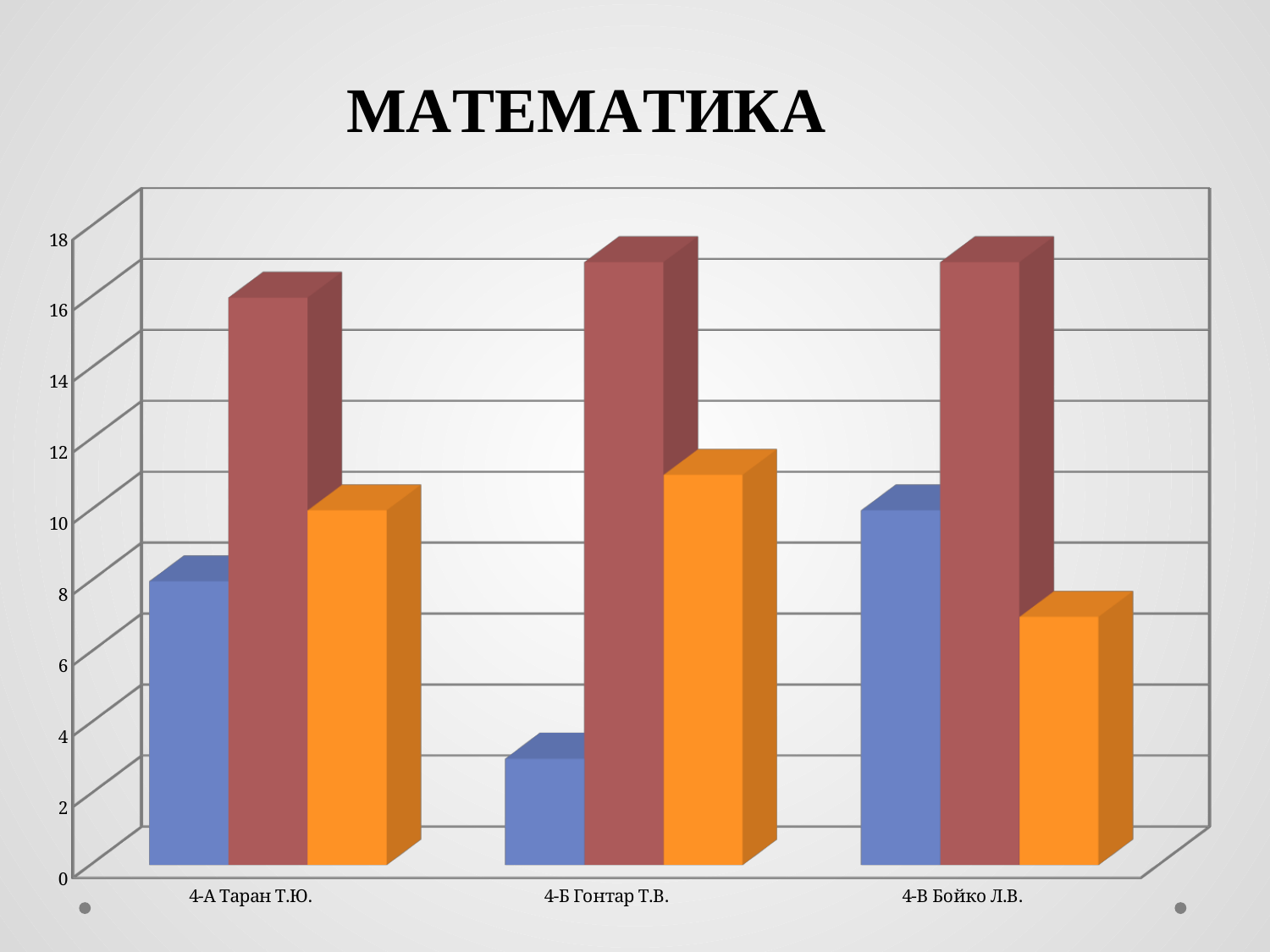
Is the value of the blue bar for 4-А Таран Т.Ю. greater or less than 10? less What kind of chart is shown on the slide? bar chart Which category has the shortest orange bar? 4-В Бойко Л.В. Is the value of the red bar for 4-Б Гонтар Т.В. greater or less than 16? greater For 4-Б Гонтар Т.В., which is larger: the red bar or the blue bar? the red bar Which category has the tallest blue bar? 4-В Бойко Л.В. What is the title of the chart? МАТЕМАТИКА Is the value of the blue bar for 4-Б Гонтар Т.В. greater or less than 4? less How many categories are shown on the x axis of the chart? 3 Which category has the shortest blue bar? 4-Б Гонтар Т.В.